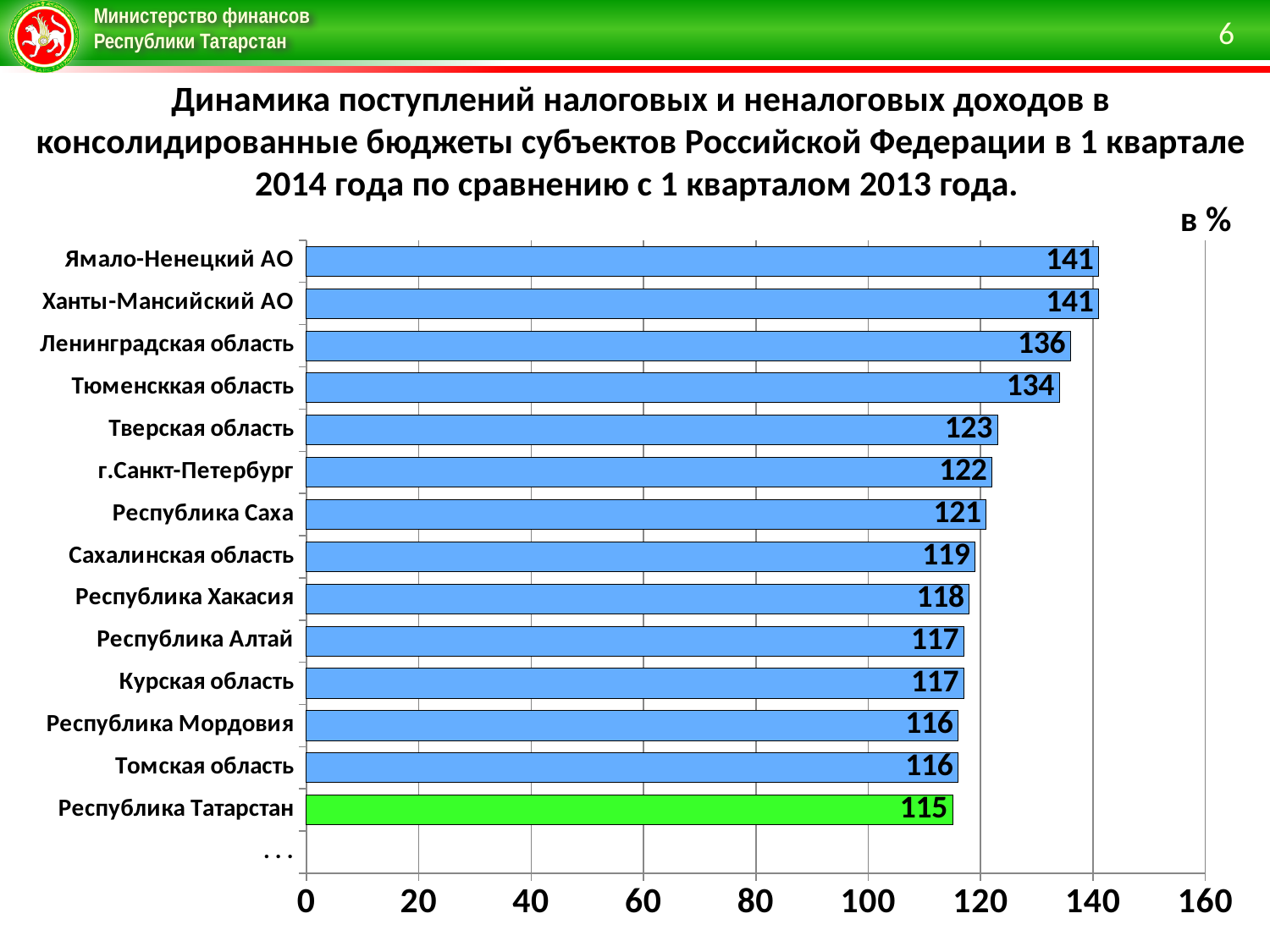
Is the value for Ханты-Мансийский АО greater or less than 140? greater What is the value for Сахалинская область? 119 Which bar is coloured green instead of blue? Республика Татарстан How many regions have bars plotted on the chart? 14 What kind of chart is shown on the slide? bar chart What is the value for Республика Татарстан? 115 What is the value for Ленинградская область? 136 Which region has the lowest value among the bars shown? Республика Татарстан What is the value for г.Санкт-Петербург? 122 What is the difference between the values for Ямало-Ненецкий АО and Республика Татарстан? 26 What is the difference between the values for Тюменсккая область and Тверская область? 11 Which is larger, the value for Республика Саха or the value for Республика Хакасия? Республика Саха